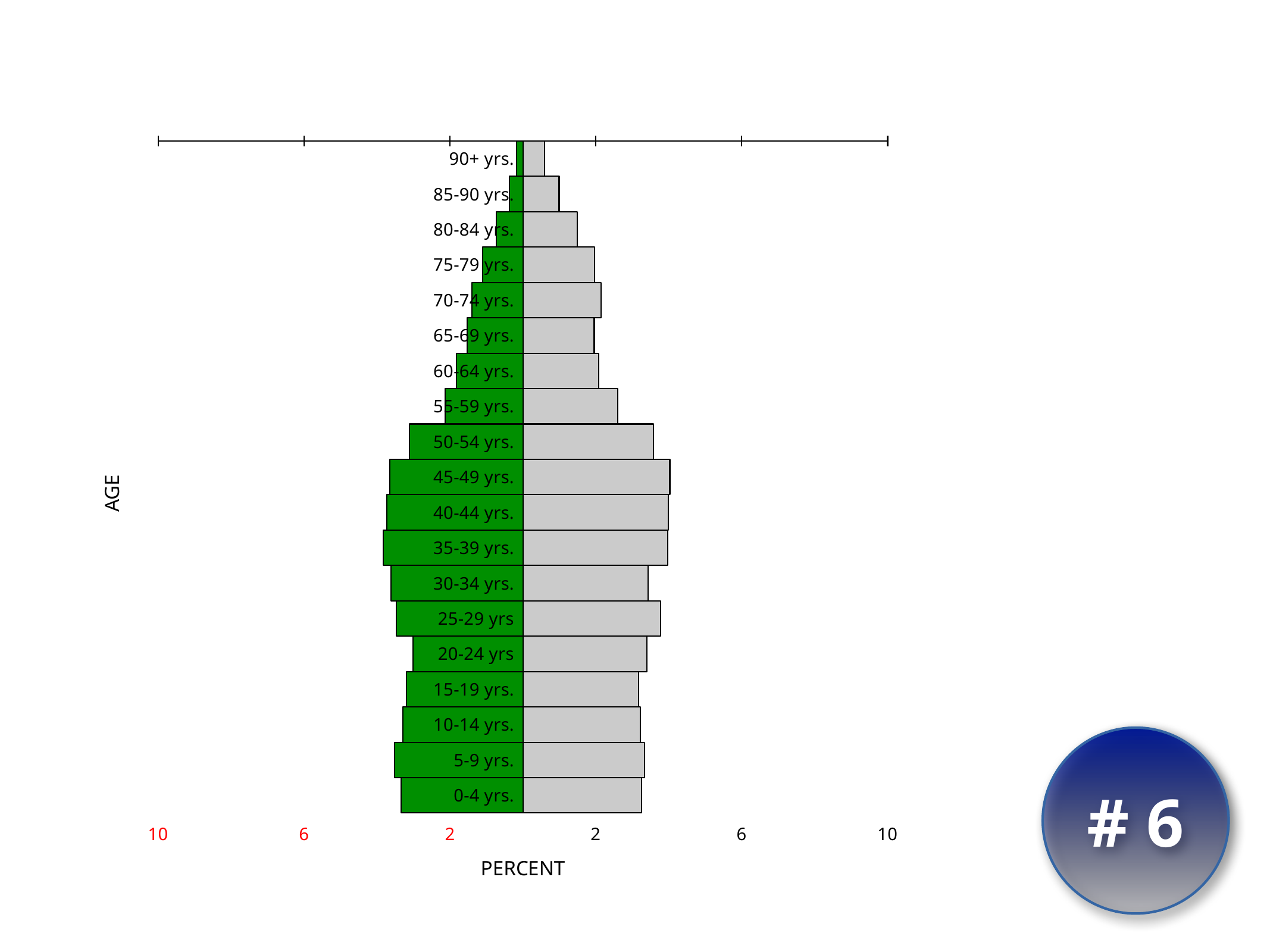
What kind of chart is shown on the slide? bar chart Is the grey bar for 45-49 yrs. greater or less than 6 percent? less Is the grey bar for 0-4 yrs. greater or less than 2 percent? greater What is the label of the vertical axis? AGE How many age groups are plotted on the chart? 19 What is the label of the horizontal axis? PERCENT Is the grey bar for 90+ yrs. greater or less than 2 percent? less Which is larger, the grey bar for 50-54 yrs. or the grey bar for 55-59 yrs.? 50-54 yrs. Which age group has the shortest grey bar? 90+ yrs. Which age group has the shortest green bar? 90+ yrs.